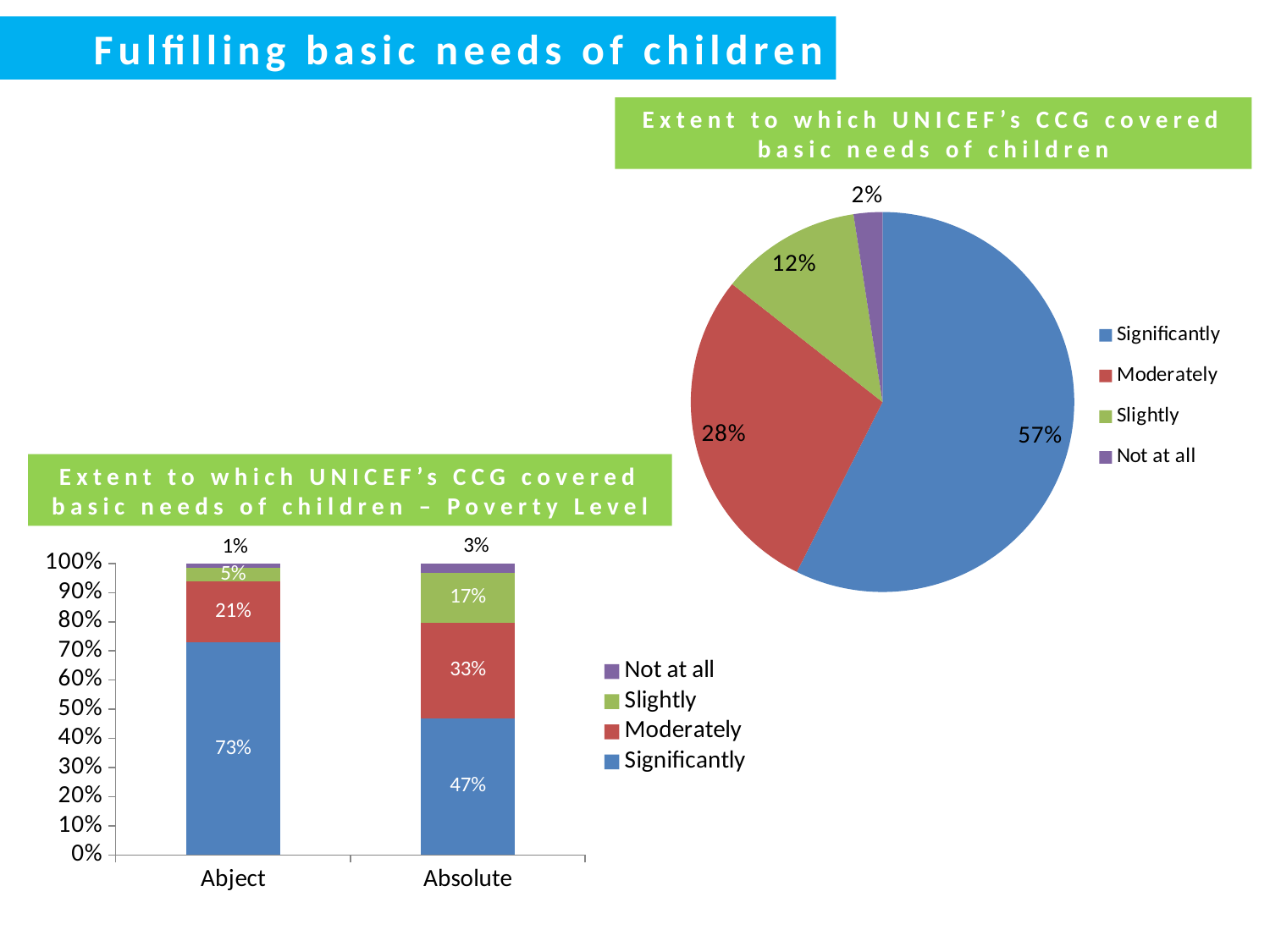
In the pie chart 'Extent to which UNICEF's CCG covered basic needs of children', what share is labelled for Significantly? 57% In the pie chart 'Extent to which UNICEF's CCG covered basic needs of children', which category has the smallest slice? Not at all What type of chart is the chart at the bottom left of the slide? Stacked bar chart In the bar chart 'Extent to which UNICEF's CCG covered basic needs of children – Poverty Level', what is the Moderately value for Absolute? 33% In the bar chart 'Extent to which UNICEF's CCG covered basic needs of children – Poverty Level', what is the Significantly value for Abject? 73% In the pie chart 'Extent to which UNICEF's CCG covered basic needs of children', how many categories does the legend list? 4 In the pie chart 'Extent to which UNICEF's CCG covered basic needs of children', what is the difference between the Significantly and Moderately shares? 29% In the bar chart 'Extent to which UNICEF's CCG covered basic needs of children – Poverty Level', what is the Not at all value for Absolute? 3% In the pie chart 'Extent to which UNICEF's CCG covered basic needs of children', which category has the largest slice? Significantly In the pie chart 'Extent to which UNICEF's CCG covered basic needs of children', what share is labelled for Moderately? 28% In the bar chart 'Extent to which UNICEF's CCG covered basic needs of children – Poverty Level', which poverty level has the larger Slightly value, Abject or Absolute? Absolute In the bar chart 'Extent to which UNICEF's CCG covered basic needs of children – Poverty Level', what is the difference between the Significantly values for Abject and Absolute? 26%